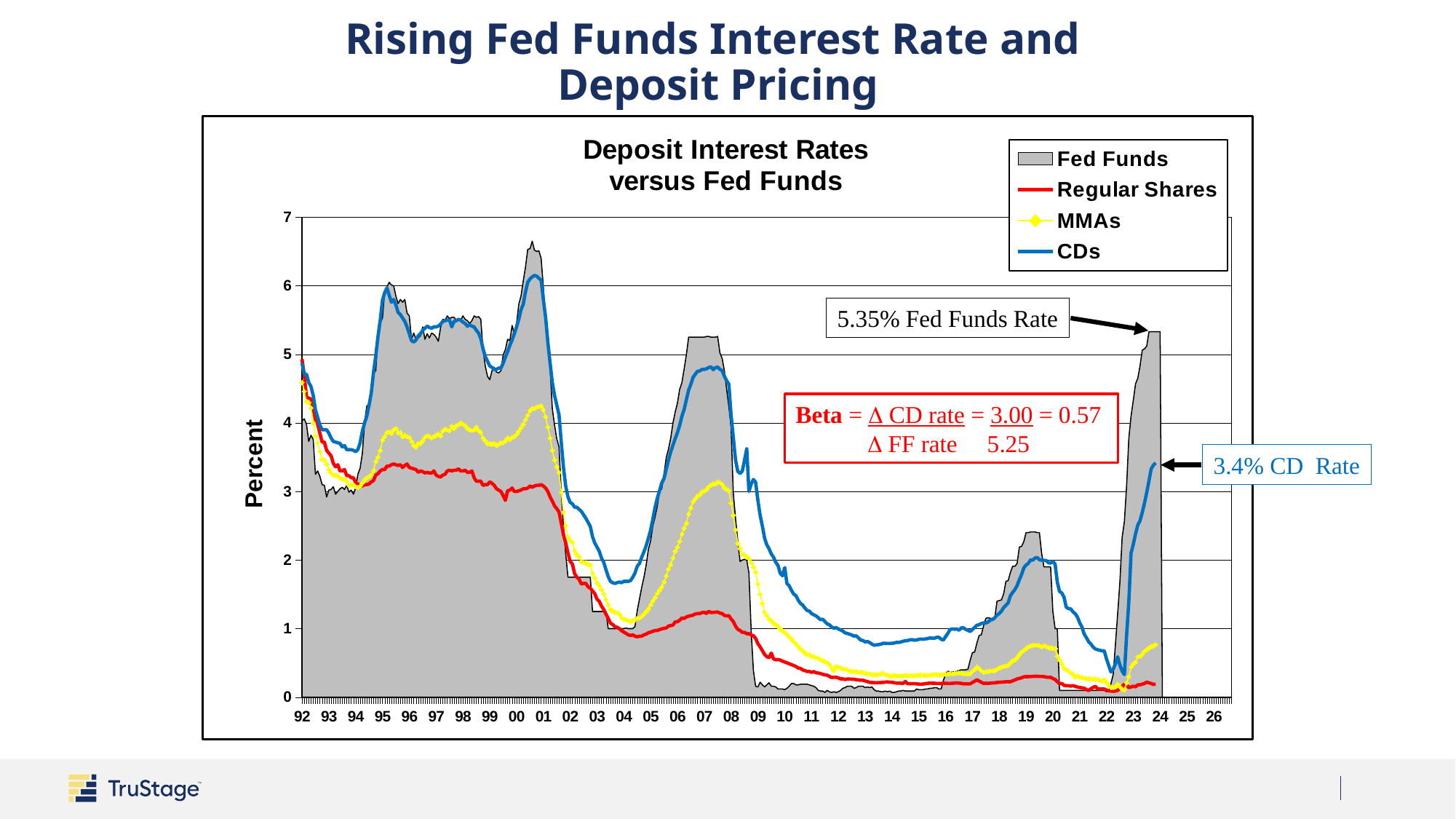
What Beta value is shown in the red box on the chart? 0.57 What CD rate is called out in the annotation at the right end of the chart? 3.4% Is the value of the Regular Shares line in 2023 greater or less than 1? less What is the label on the vertical axis? Percent What is the title of the chart? Deposit Interest Rates versus Fed Funds Is the peak value of the CDs line around 2001 greater or less than 6? greater How many series does the legend list? 4 What type of chart is shown on the slide? combination area and line chart What is the difference between the annotated 5.35% Fed Funds rate and the annotated 3.4% CD rate? 1.95% What is the change in the FF rate (Δ FF rate) shown in the Beta calculation? 5.25 What Fed Funds rate is called out in the annotation at the right end of the chart? 5.35% Around 2007, which is higher: the CDs line or the Regular Shares line? CDs